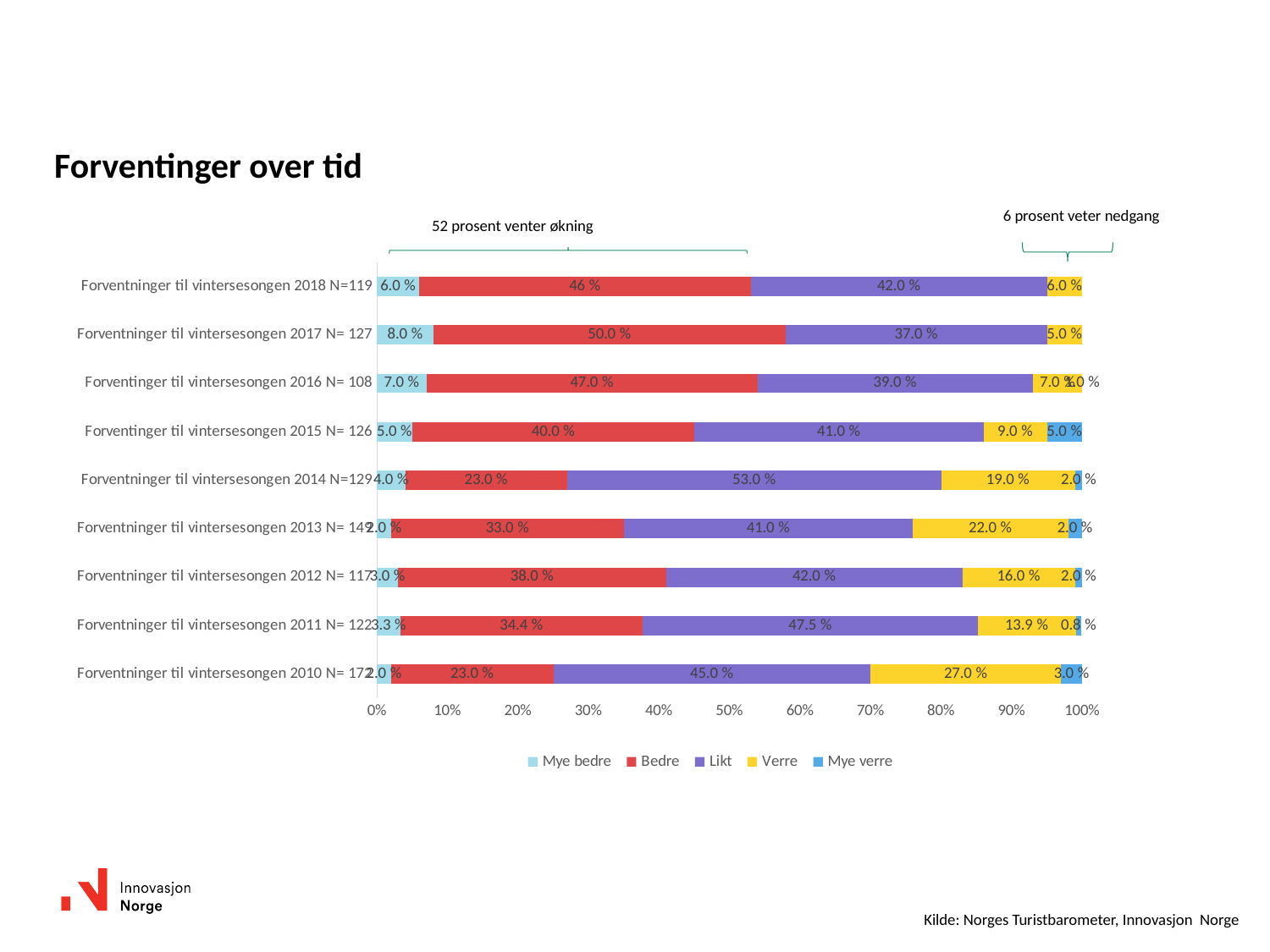
Which season has the highest "Likt" value? Forventninger til vintersesongen 2014 N=129 Which has the larger "Likt" value: the 2011 season or the 2012 season? Forventninger til vintersesongen 2011 N= 122 Which season has the highest "Bedre" value? Forventninger til vintersesongen 2017 N= 127 What is the value of the "Verre" segment for "Forventninger til vintersesongen 2010 N= 172"? 27.0 % What is the value of the "Mye bedre" segment for "Forventninger til vintersesongen 2017 N= 127"? 8.0 % What is the value of the "Mye verre" segment for "Forventninger til vintersesongen 2011 N= 122"? 0.8 % How many series does the legend list? 5 What is the value of the "Bedre" segment for "Forventninger til vintersesongen 2017 N= 127"? 50.0 % What is the value of the "Likt" segment for "Forventninger til vintersesongen 2014 N=129"? 53.0 % Which season has the highest "Verre" value? Forventninger til vintersesongen 2010 N= 172 How many seasons (bars) are shown in the chart? 9 What is the difference between the "Bedre" values for the 2017 season (50.0 %) and the 2018 season (46 %)? 4 percentage points